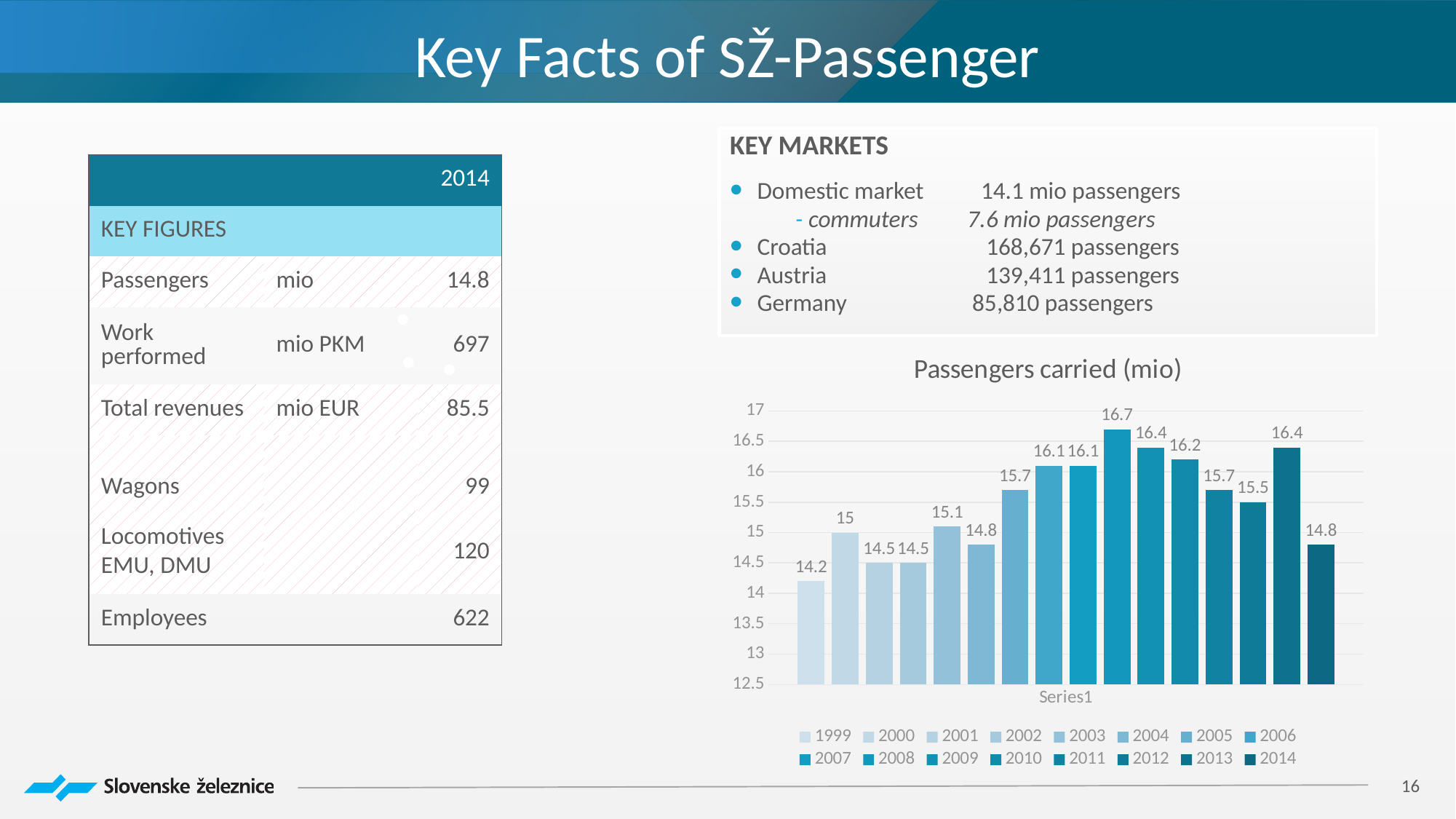
In the 'Passengers carried (mio)' chart, which is larger, the value for 2013 or the value for 2012? 2013 In the 'Passengers carried (mio)' chart, which year has the highest value? 2008 In the 'Passengers carried (mio)' chart, what is the value for 1999? 14.2 In the 'Passengers carried (mio)' chart, is the value for 2005 greater or less than 15? greater How many entries does the legend of the 'Passengers carried (mio)' chart list? 16 How many bars are plotted in the 'Passengers carried (mio)' chart? 16 In the 'Passengers carried (mio)' chart, which year has the lowest value? 1999 In the 'Passengers carried (mio)' chart, what is the value for 2008? 16.7 What is the title of the chart on the slide? Passengers carried (mio) In the 'Passengers carried (mio)' chart, what is the value for 2014? 14.8 What type of chart is shown under the title 'Passengers carried (mio)'? bar chart In the 'Passengers carried (mio)' chart, what is the difference between the values for 2008 and 2014? 1.9